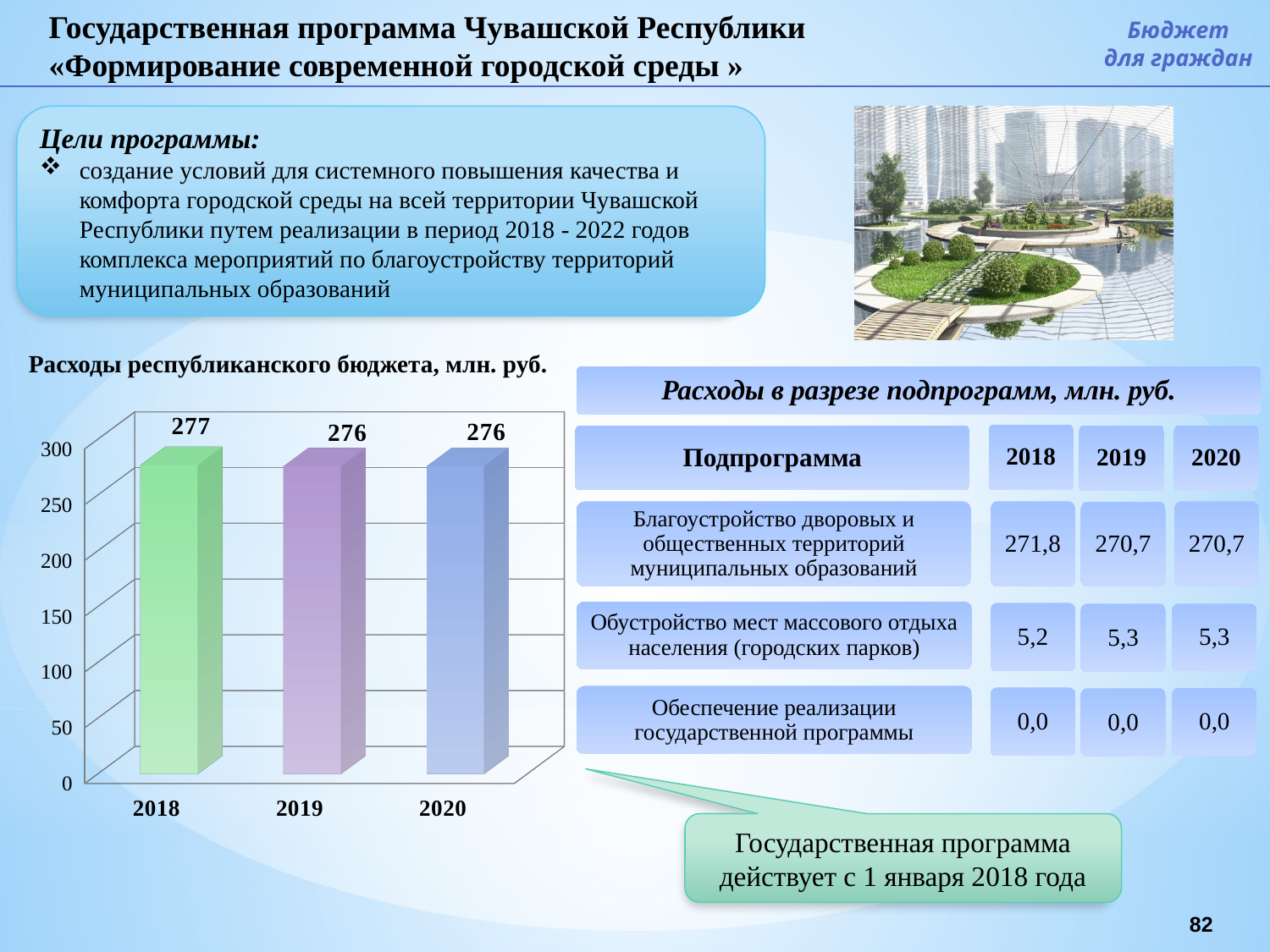
What is the value for 2018 in the chart 'Расходы республиканского бюджета, млн. руб.'? 277 What kind of chart is shown on the slide? bar chart How many years are shown on the x axis of the chart? 3 What is the difference between the values for 2018 and 2019? 1 Is the value for 2019 greater or less than 250? greater What colour is the bar for 2018? green What is the title of the chart? Расходы республиканского бюджета, млн. руб. What is the value for 2019 in the chart? 276 Which year has the highest value in the chart? 2018 What is the value for 2020 in the chart? 276 Does the value fall or rise from 2018 to 2019? fall Which is larger, the value for 2018 or the value for 2020? 2018